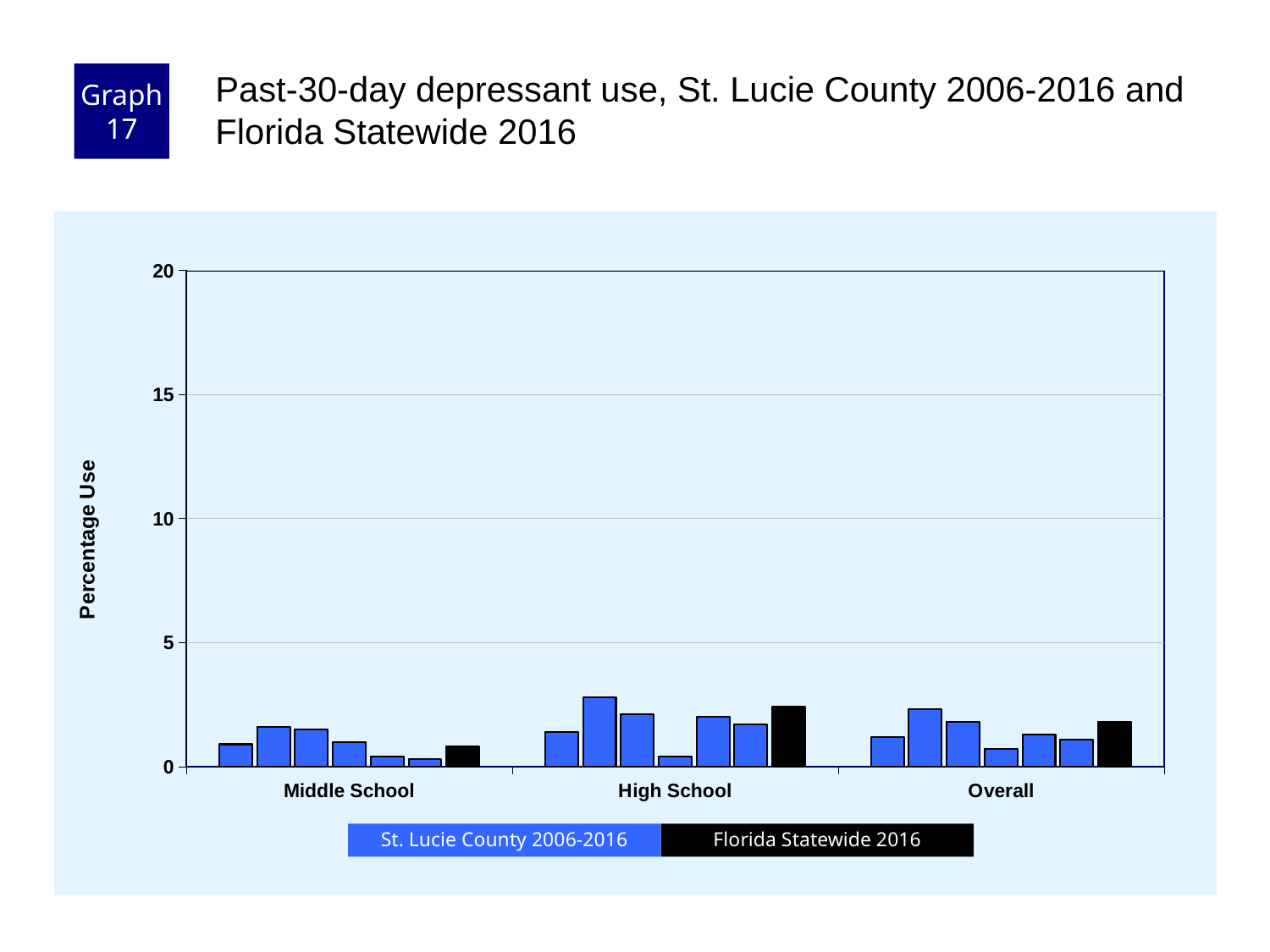
Which is larger, the Florida Statewide 2016 bar for Overall or for Middle School? Overall How many series does the legend list? 2 Which is larger, the Florida Statewide 2016 bar for High School or for Middle School? High School Is the Florida Statewide 2016 value for Middle School greater or less than 5? less What is the label on the y axis? Percentage Use Is the Florida Statewide 2016 value for High School greater or less than 5? less What kind of chart is shown on the slide? bar chart Which category has the highest Florida Statewide 2016 bar? High School Which category has the lowest Florida Statewide 2016 bar? Middle School How many categories are shown along the x axis? 3 In which category does the tallest St. Lucie County 2006-2016 bar appear? High School Which colour represents Florida Statewide 2016 in the legend? black